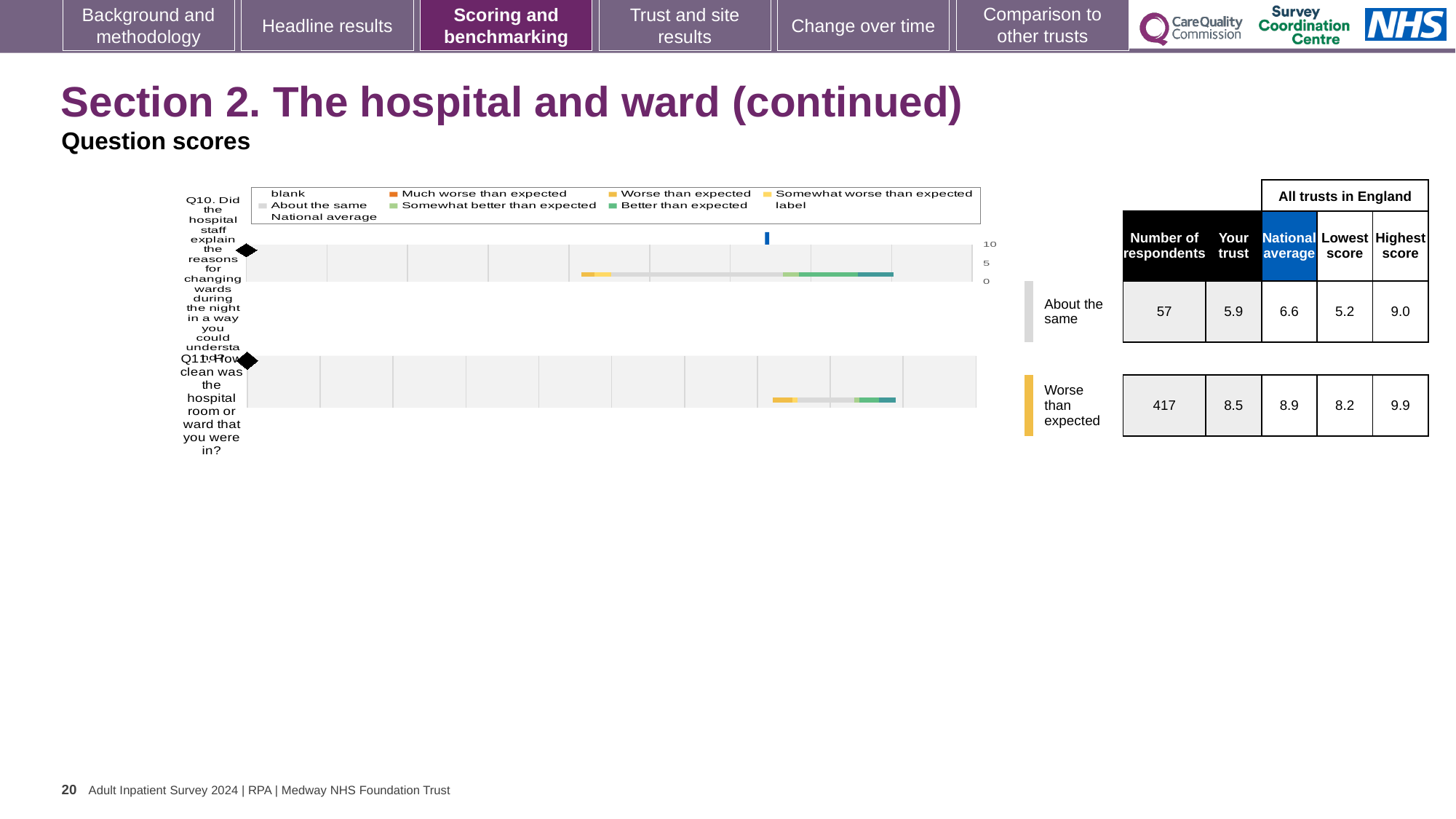
What is the national average score for Q10? 6.6 Which question has the higher 'Your trust' score, Q10 or Q11? Q11 What benchmark category is the trust's Q11 score placed in? Worse than expected What kind of chart is used to show the question scores for Q10 and Q11? bar chart What is the 'Your trust' score for Q10 (explaining reasons for changing wards during the night)? 5.9 What is the highest score among all trusts in England for Q10? 9.0 How many respondents answered Q11? 417 What is the national average score for Q11? 8.9 What is the difference between the national average and the trust score for Q10? 0.7 How many questions (Q10 and Q11) are plotted on the slide? 2 What is the 'Your trust' score for Q11 (how clean was the hospital room or ward)? 8.5 What is the maximum value shown on the score axis of the Q10 chart? 10